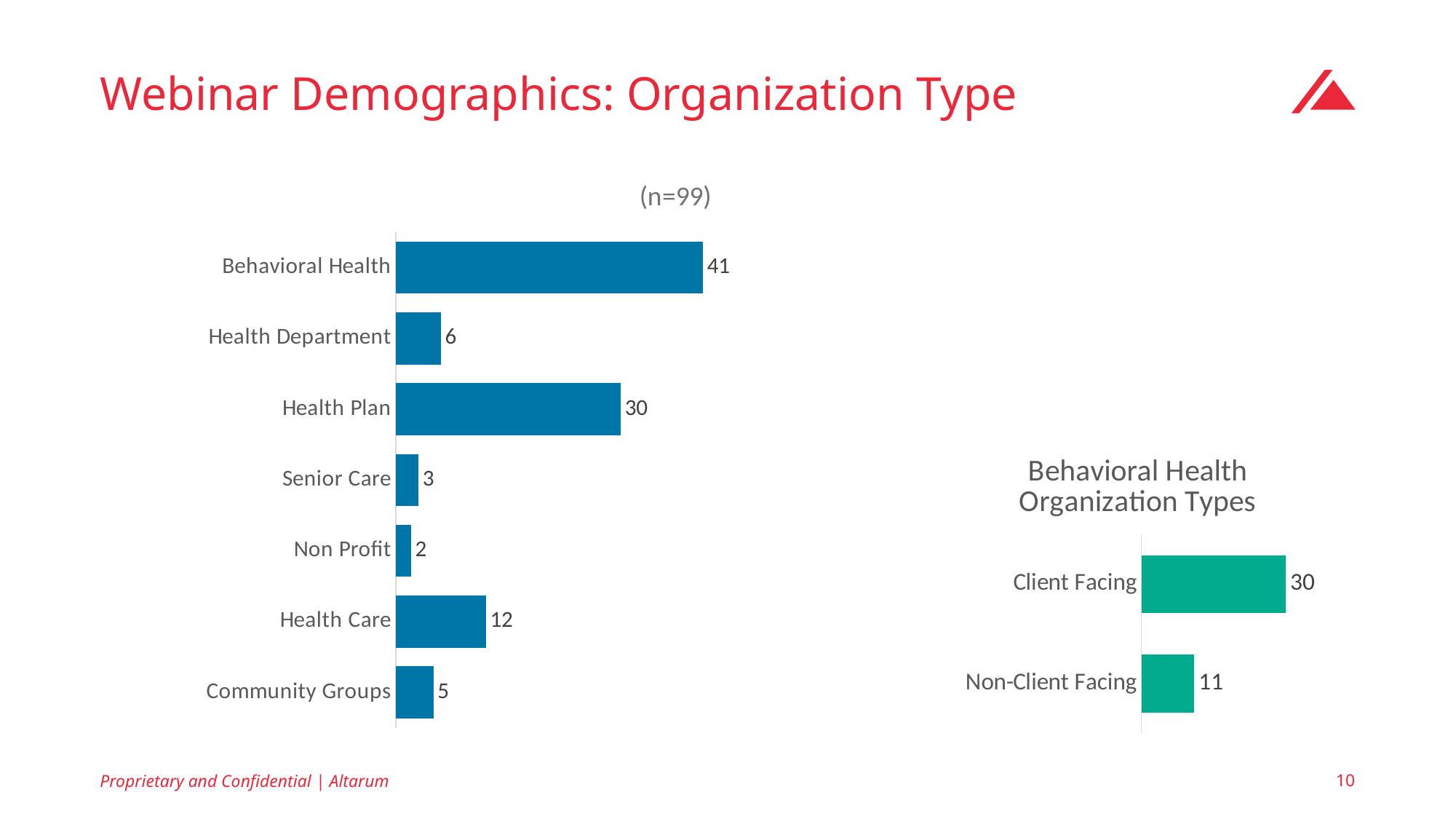
In the left chart titled (n=99), what is the value for Health Plan? 30 In the left chart titled (n=99), which category has the lowest value? Non Profit What kind of chart is the Behavioral Health Organization Types chart? Bar chart In the left chart titled (n=99), which category has the highest value? Behavioral Health In the left chart titled (n=99), what is the value for Community Groups? 5 In the Behavioral Health Organization Types chart, what is the value for Non-Client Facing? 11 In the left chart titled (n=99), what is the value for Behavioral Health? 41 What is the title of the chart on the right side of the slide? Behavioral Health Organization Types In the Behavioral Health Organization Types chart, what is the difference between Client Facing and Non-Client Facing? 19 In the left chart titled (n=99), which is larger, Health Care or Health Department? Health Care In the left chart titled (n=99), what is the difference between Behavioral Health and Health Plan? 11 How many categories are shown in the left chart titled (n=99)? 7